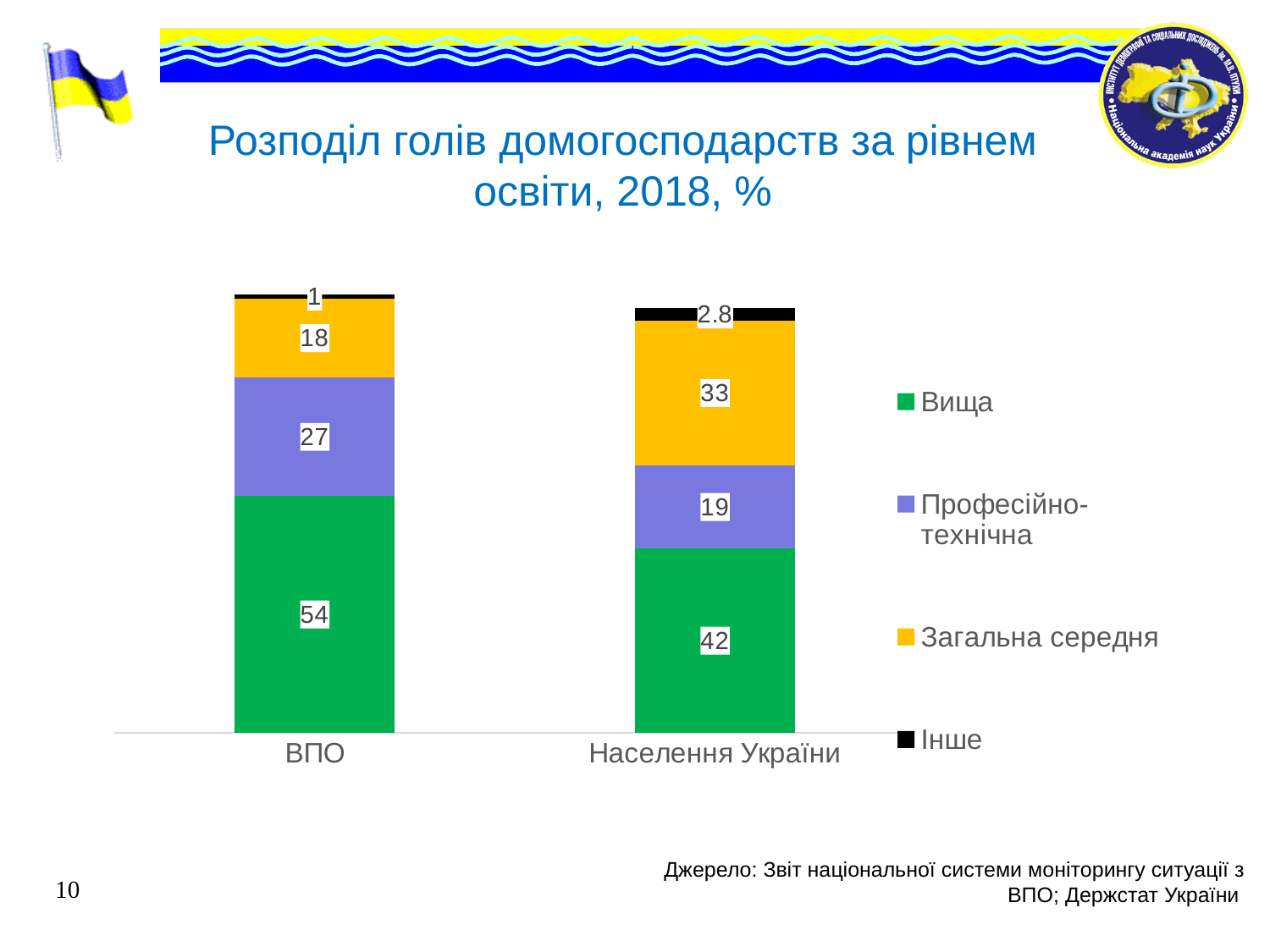
What is the value for Професійно-технічна in the ВПО bar? 27 Which category has the higher value for Вища, ВПО or Населення України? ВПО What is the value for Інше in the Населення України bar? 2.8 What is the value for Вища in the ВПО bar? 54 What is the total of the stacked bar for Населення України? 96.8 What is the difference between the Загальна середня values for Населення України and ВПО? 15 What kind of chart is shown on the slide? Stacked bar chart Which series has the smallest value in the ВПО bar? Інше Which category has the higher value for Загальна середня, ВПО or Населення України? Населення України What is the value for Загальна середня in the Населення України bar? 33 How many series does the legend list? 4 What is the difference between the Вища values for ВПО and Населення України? 12